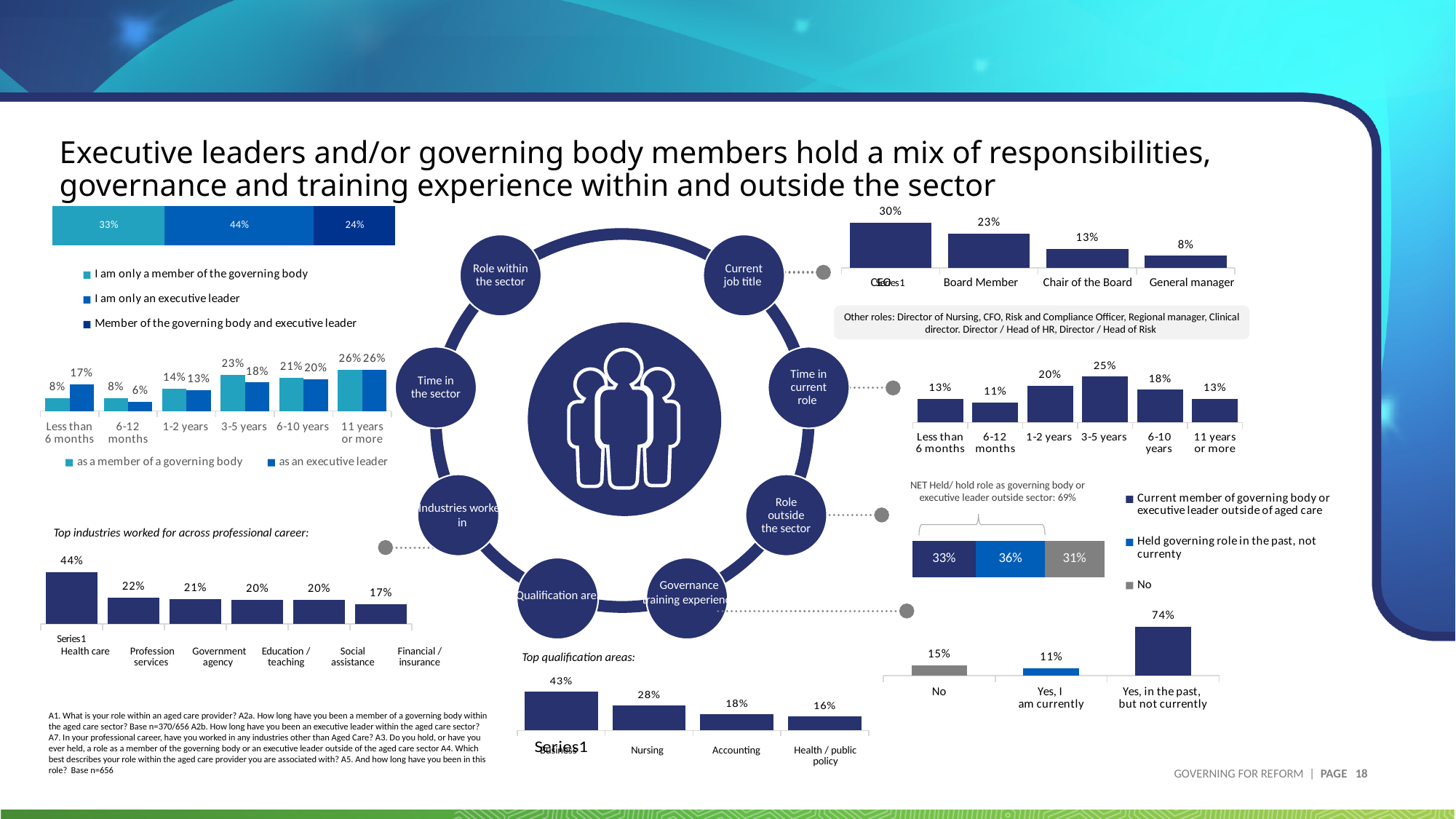
In the 'Role outside the sector' stacked bar, what is the value for 'No'? 31% In the 'Time in the sector' chart, what is the value for 'Less than 6 months' as an executive leader? 17% In the 'Top qualification areas' chart, what is the value for Nursing? 28% In the 'Current job title' chart, which job title has the lowest percentage? General manager In the 'Current job title' chart, what percentage is shown for CEO? 30% In the 'Time in current role' chart, which category has the highest value? 3-5 years In the 'Top industries worked for across professional career' chart, what is the value for Health care? 44% How many industries are shown in the 'Top industries worked for across professional career' chart? 6 In the 'Governance training experience' chart, which category has the highest value? Yes, in the past, but not currently How many series does the legend of the 'Time in the sector' chart list? 2 In the 'Time in current role' chart, what is the difference between the values for 3-5 years and 6-12 months? 14% In the 'Role within the sector' stacked bar at the top left, what is the value for 'I am only an executive leader'? 44%